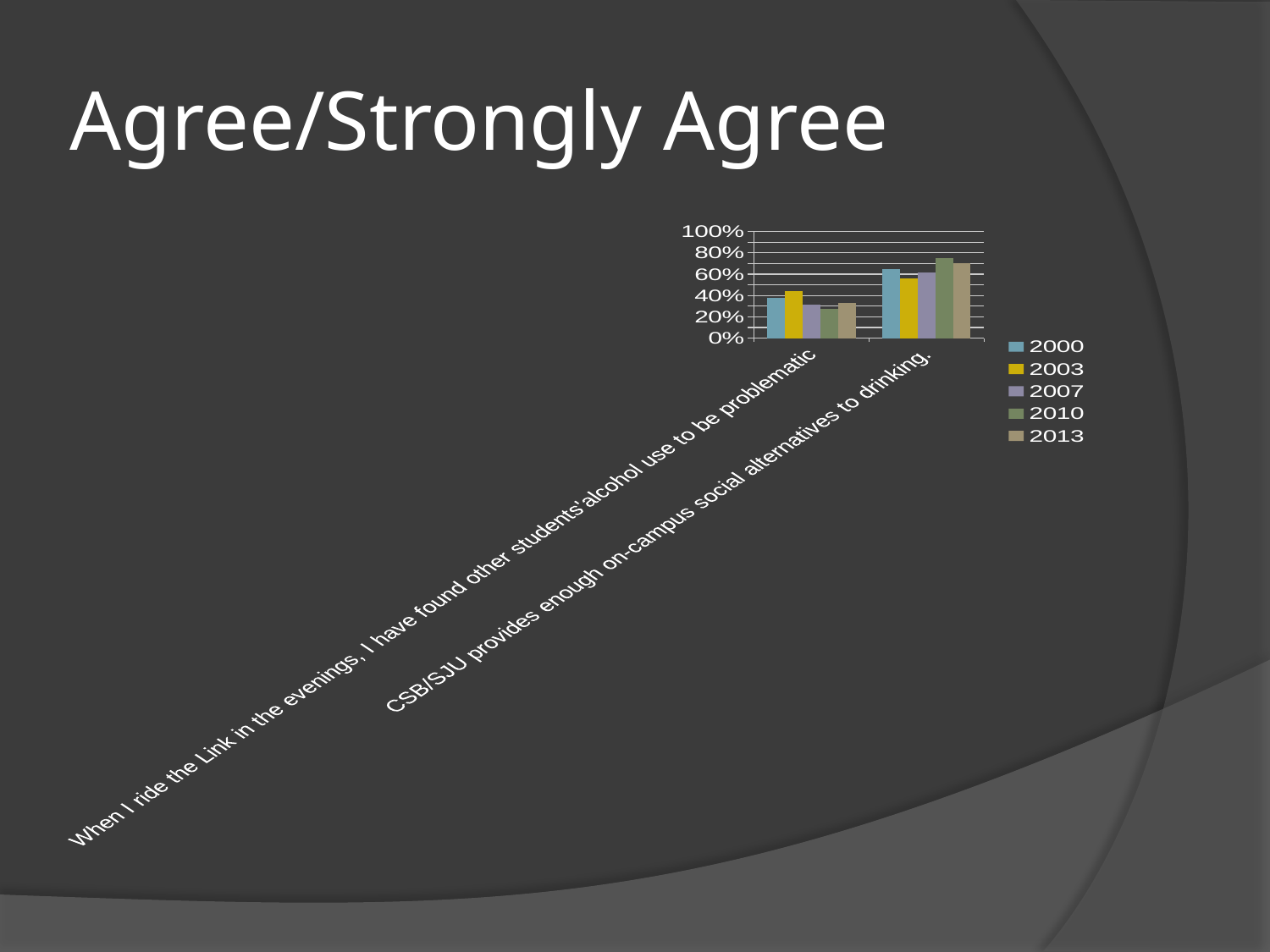
Is the 2003 value for "When I ride the Link in the evenings, I have found other students' alcohol use to be problematic" greater or less than 20%? greater Is the 2010 value for "CSB/SJU provides enough on-campus social alternatives to drinking." greater or less than 60%? greater Which year has the highest value for "When I ride the Link in the evenings, I have found other students' alcohol use to be problematic"? 2003 How many categories are shown on the x axis of the chart? 2 How many series does the legend list? 5 What is the title of the slide containing the chart? Agree/Strongly Agree Which years are listed in the chart's legend? 2000, 2003, 2007, 2010, 2013 Is the 2000 value for "CSB/SJU provides enough on-campus social alternatives to drinking." greater or less than 80%? less What kind of chart is shown on the slide? bar chart Which year has the highest value for "CSB/SJU provides enough on-campus social alternatives to drinking."? 2010 For the year 2013, which category has the larger value: "When I ride the Link in the evenings, I have found other students' alcohol use to be problematic" or "CSB/SJU provides enough on-campus social alternatives to drinking."? CSB/SJU provides enough on-campus social alternatives to drinking.